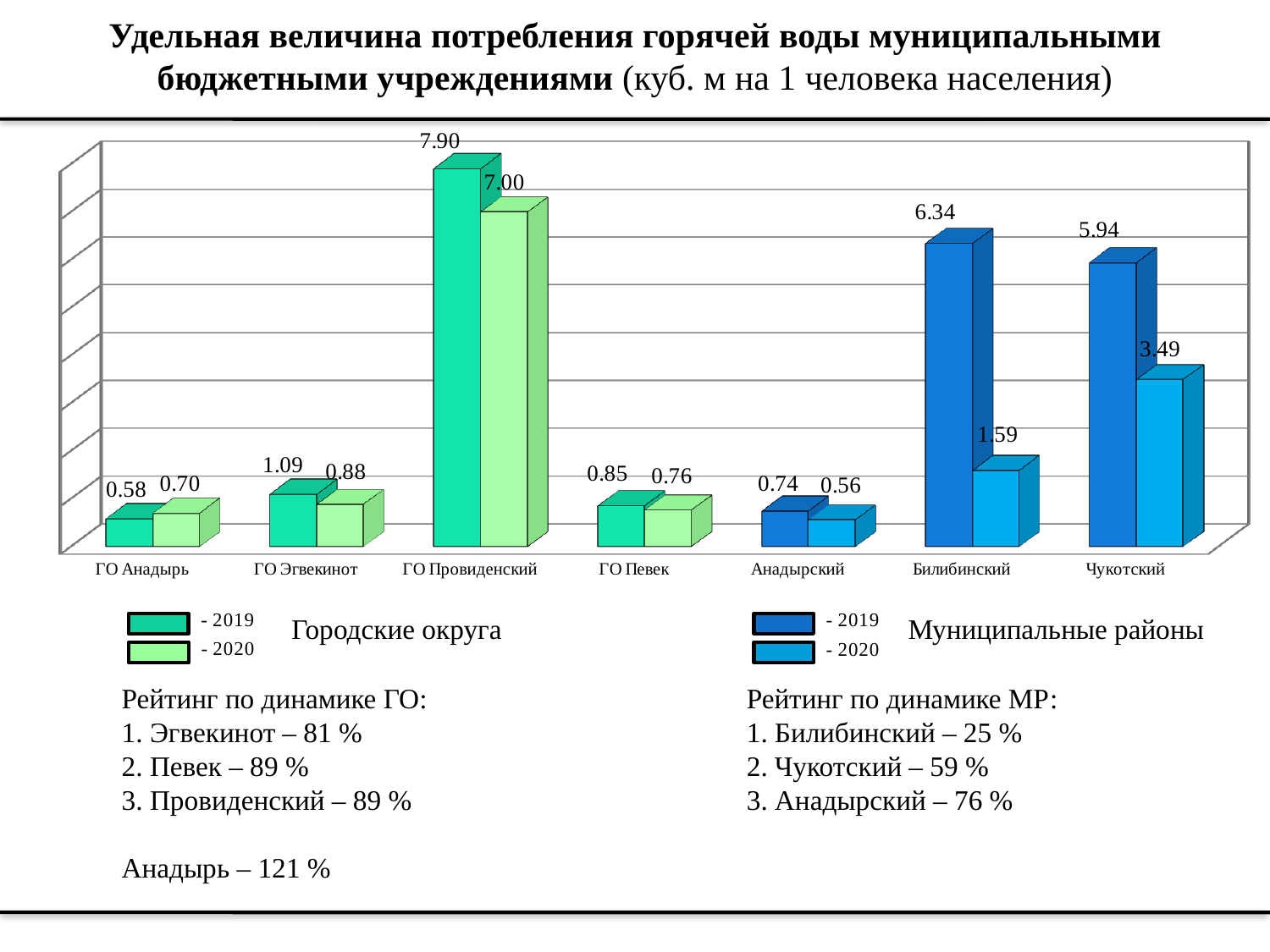
Which territory has the lowest 2020 value? Анадырский What kind of chart is shown on the slide? Bar chart How many years does the legend compare for each territory? 2 Which is larger: the 2020 value for Чукотский or the 2020 value for Билибинский? Чукотский What is the difference between the 2019 and 2020 values for Билибинский? 4.75 What is the 2019 value for ГО Провиденский? 7.90 What is the 2019 value for Чукотский? 5.94 What is the 2020 value for Билибинский? 1.59 How many territories (categories) are shown on the x axis of the chart? 7 Which colour represents the 2020 series for the municipal districts (Муниципальные районы)? Light blue Which territory has the highest 2019 value? ГО Провиденский Did the value for Чукотский rise or fall from 2019 to 2020? Fall